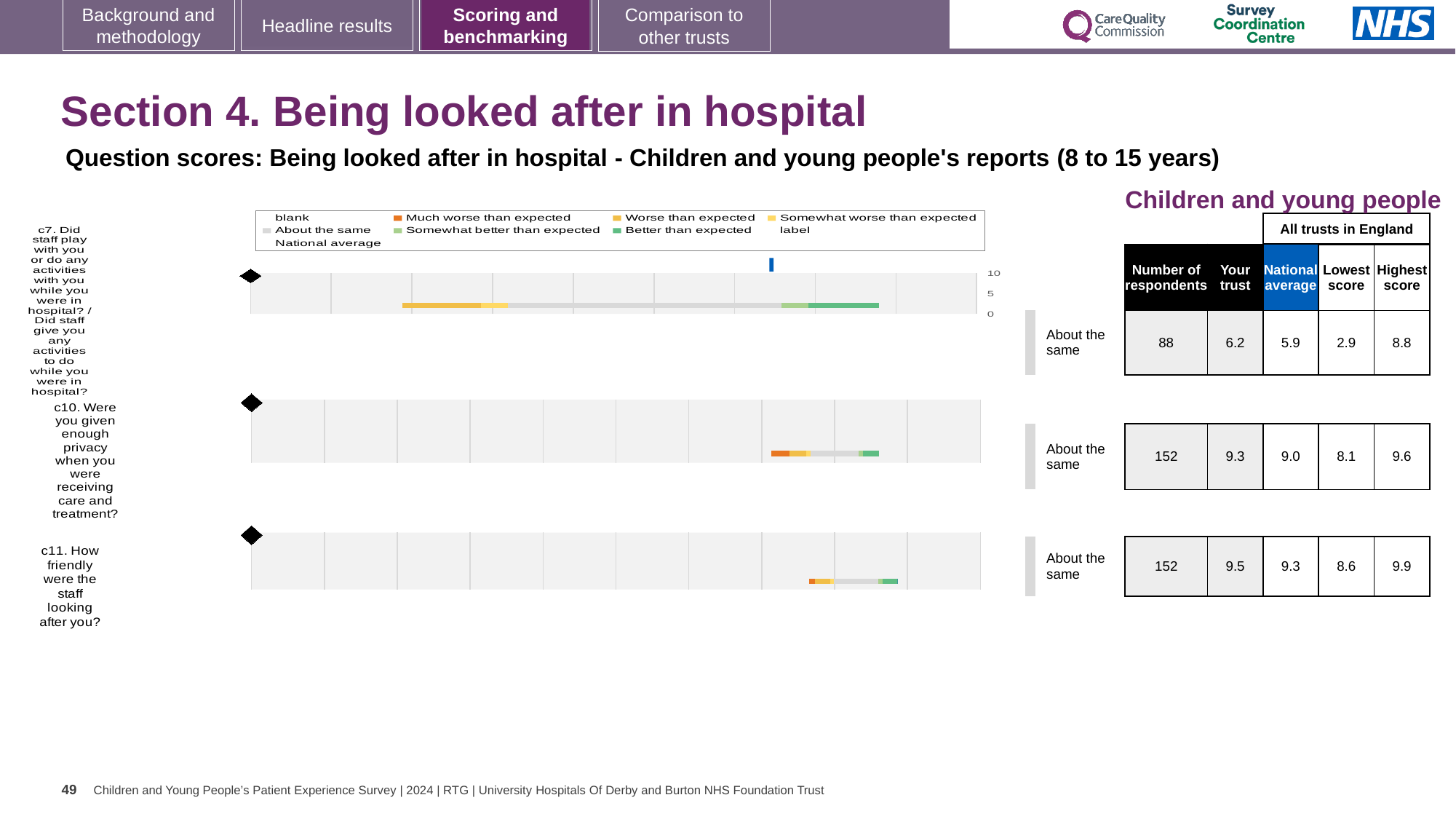
What is the difference between the 'Your trust' score and the national average for question c7? 0.3 Which is larger, the 'Your trust' score for c10 or for c11? c11 (9.5) What kind of chart is used to show the question scores on this slide? bar chart How many questions (chart rows) are plotted on this slide? 3 What is the national average score for question c10 (Were you given enough privacy when you were receiving care and treatment?)? 9.0 How many respondents answered question c7? 88 What benchmark category is shown for all three questions on this slide? About the same What is the highest score across all trusts in England for question c11 (How friendly were the staff looking after you?)? 9.9 Which question has the lowest 'Your trust' score? c7. Did staff play with you or do any activities with you while you were in hospital? How many entries does the chart legend list? 9 What is the 'Your trust' score for question c7 (Did staff play with you or do any activities with you while you were in hospital?)? 6.2 Which question has the highest 'Your trust' score? c11. How friendly were the staff looking after you?